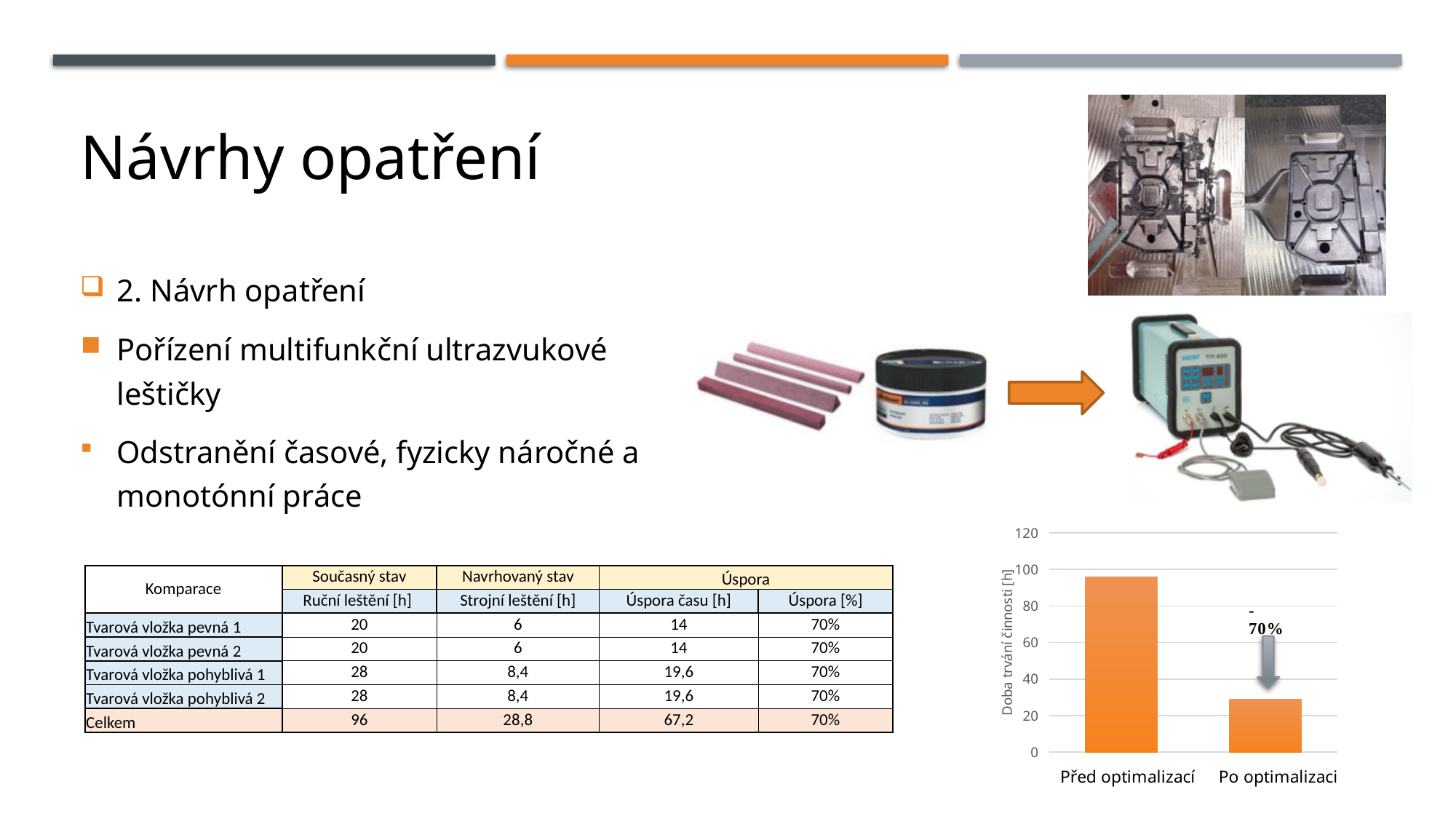
Which category in the bar chart has the lowest value? Po optimalizaci What percentage change is annotated between the two bars in the bar chart? -70% In the bar chart, which is larger: the value for Před optimalizací or the value for Po optimalizaci? Před optimalizací How many categories are shown on the x axis of the bar chart? 2 In the bar chart, is the value for Po optimalizaci greater or less than 40? less Do the values in the bar chart rise or fall from left to right along the x axis? fall What is the label of the y axis of the bar chart? Doba trvání činnosti [h] What kind of chart is shown at the bottom right of the slide? bar chart In the bar chart, is the value for Před optimalizací greater or less than 100? less In the bar chart, is the value for Po optimalizaci greater or less than 20? greater Which category in the bar chart has the highest value? Před optimalizací